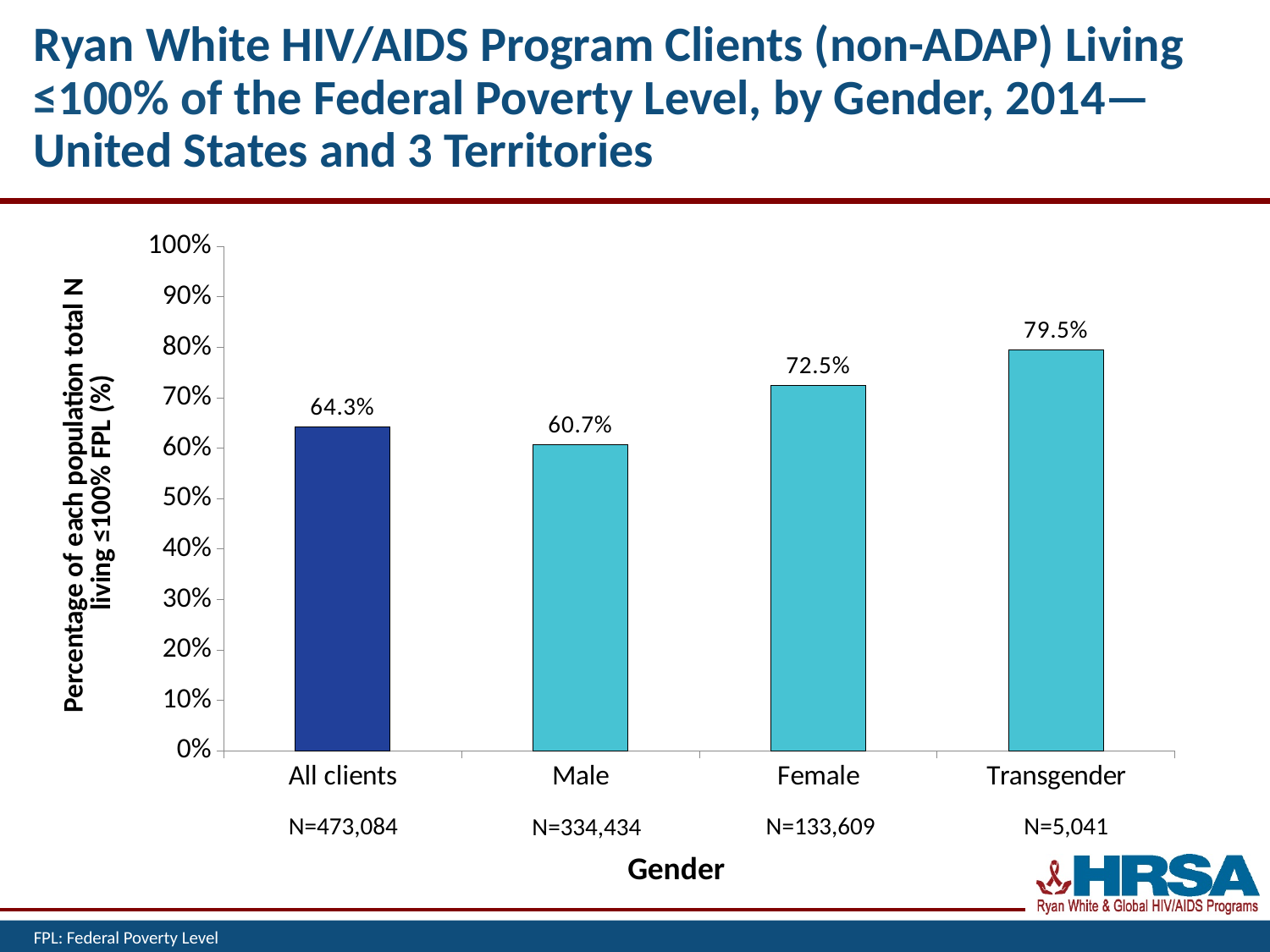
What is the value shown for Female clients? 72.5% How many categories are shown on the x axis? 4 Which gender category has the highest percentage living ≤100% FPL? Transgender What is the value shown for Transgender clients? 79.5% Which gender category has the lowest percentage living ≤100% FPL? Male What is the N (total population) shown for Transgender clients? N=5,041 What kind of chart is shown on the slide? Bar chart What is the difference in percentage points between Female and All clients? 8.2 What is the value shown for Male clients? 60.7% Which is larger, the value for Female or the value for Male? Female What is the difference in percentage points between Transgender and Male clients? 18.8 What percentage of all clients live at or below 100% of the Federal Poverty Level? 64.3%